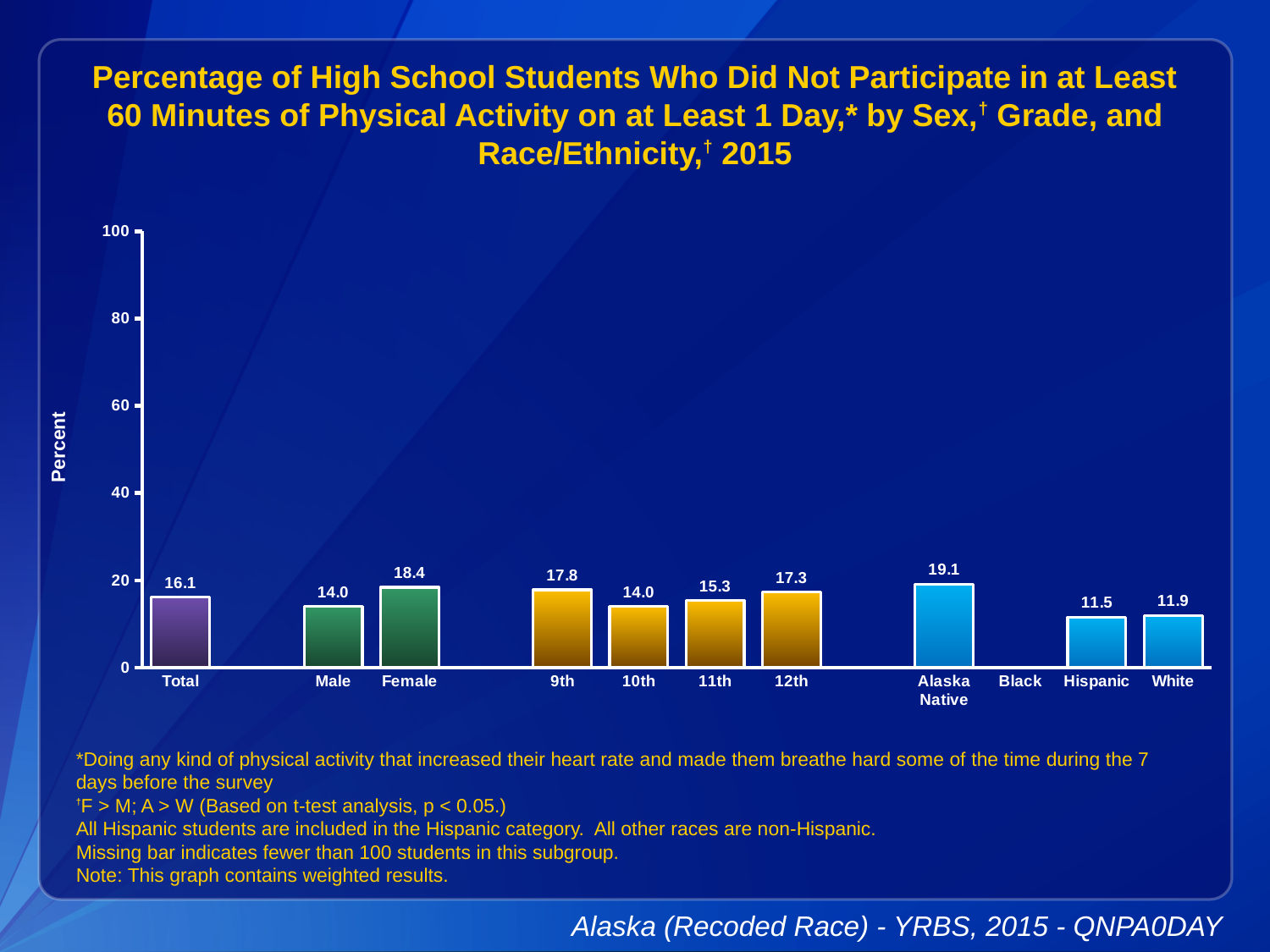
What is the value for Female? 18.4 What kind of chart is shown? bar chart What is the difference between the Female and Male values? 4.4 What is the difference between the Alaska Native and White values? 7.2 What is the value for Total? 16.1 Which is larger, the value for 11th grade or 12th grade? 12th Which category has the highest value? Alaska Native What is the value for 11th grade? 15.3 How many bars are plotted on the chart? 11 Which category has the lowest plotted value? Hispanic Is the value for Total greater or less than 20? less Which category label has no bar plotted? Black